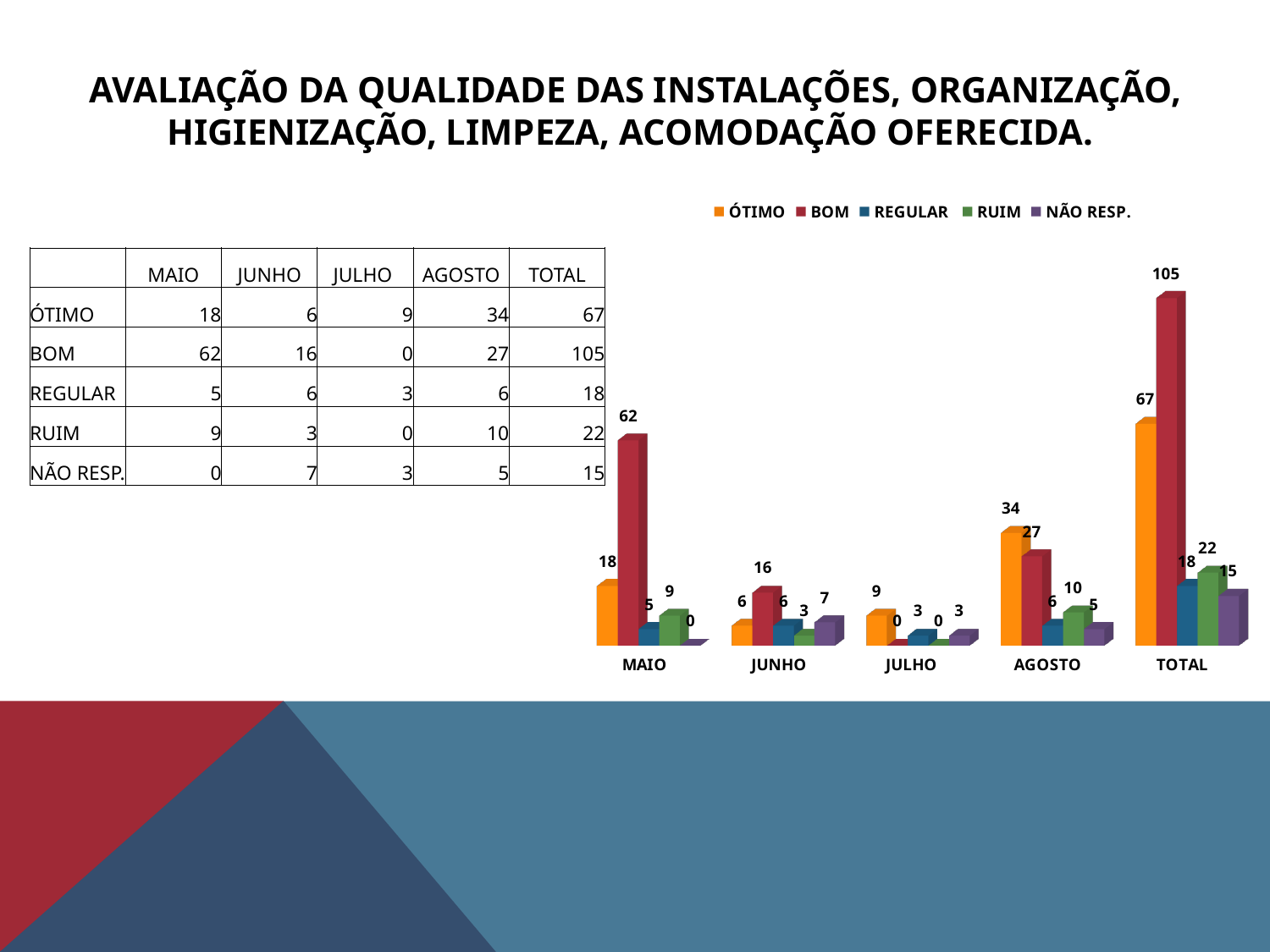
What is the value for ÓTIMO in AGOSTO on the chart? 34 What is the value for BOM in MAIO on the chart? 62 How many categories are shown on the x axis of the chart? 5 How many series does the chart legend list? 5 What kind of chart is shown on the slide? Bar chart What is the difference between the BOM and ÓTIMO values in the TOTAL category? 38 Which legend entry is shown in orange on the chart? ÓTIMO Which series has the highest value in the TOTAL category? BOM What is the value for NÃO RESP. in JUNHO on the chart? 7 What is the value for RUIM in JULHO on the chart? 0 Which is larger in AGOSTO, ÓTIMO or BOM? ÓTIMO Which series has the lowest value in the MAIO category? NÃO RESP.